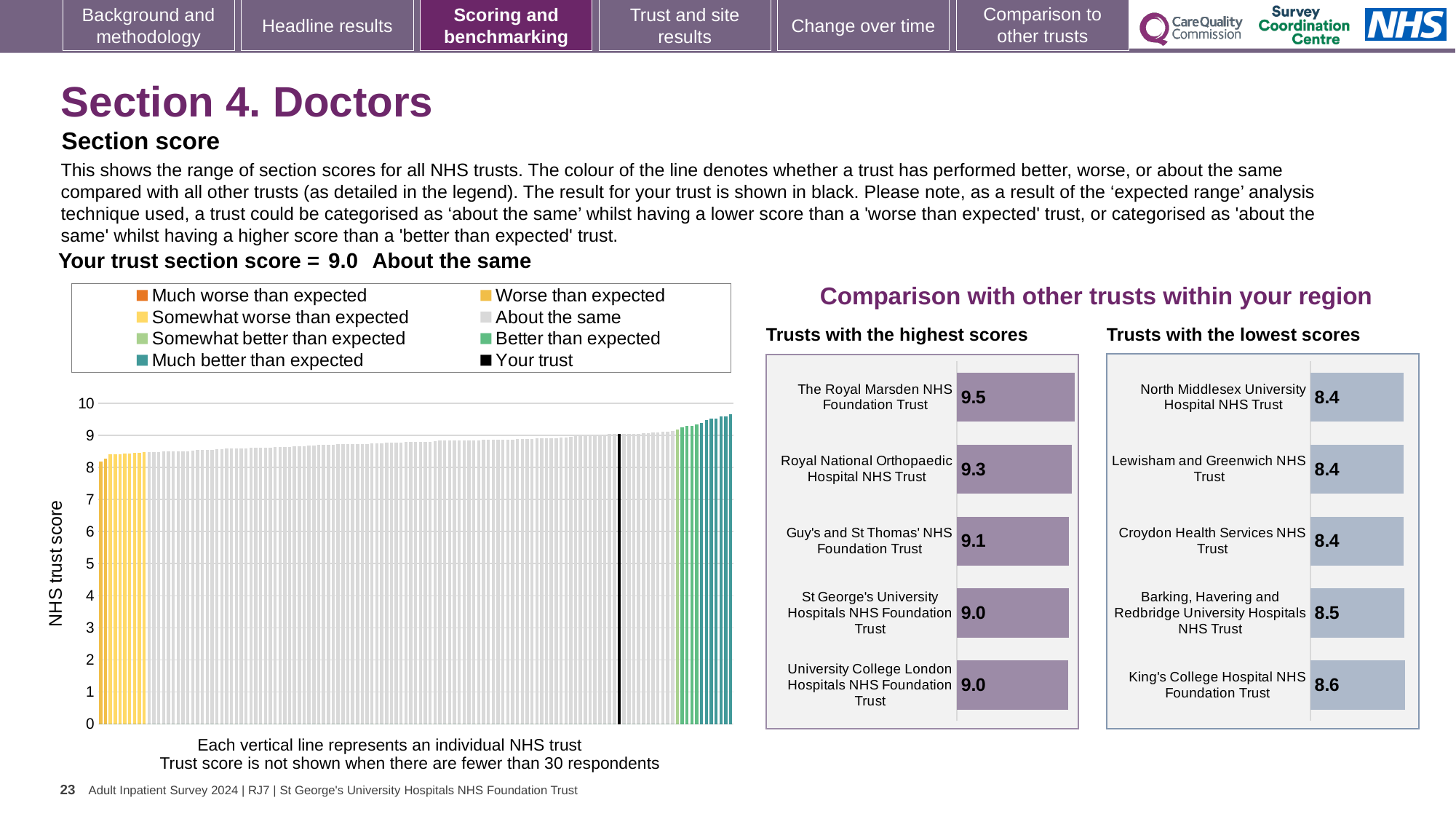
In the 'Trusts with the highest scores' chart, how many trusts are shown? 5 In the 'Trusts with the highest scores' chart, which has the larger score: Royal National Orthopaedic Hospital NHS Trust or Guy's and St Thomas' NHS Foundation Trust? Royal National Orthopaedic Hospital NHS Trust In the large chart on the left, how many entries does the legend list? 8 In the 'Trusts with the lowest scores' chart, what is the score for King's College Hospital NHS Foundation Trust? 8.6 In the large chart on the left, what colour does the legend use for 'Your trust'? black What kind of chart is the large chart on the left with the y-axis labelled 'NHS trust score'? bar chart In the large chart on the left, is the value of the black bar (your trust) greater or less than 8? greater In the 'Trusts with the highest scores' chart, what is the difference between the scores of The Royal Marsden NHS Foundation Trust and Guy's and St Thomas' NHS Foundation Trust? 0.4 In the 'Trusts with the highest scores' chart, which trust has the highest score? The Royal Marsden NHS Foundation Trust In the 'Trusts with the lowest scores' chart, what is the difference between the scores of King's College Hospital NHS Foundation Trust and Barking, Havering and Redbridge University Hospitals NHS Trust? 0.1 In the large chart on the left, do the trust scores rise or fall from left to right along the x axis? rise In the 'Trusts with the highest scores' chart, what is the score for The Royal Marsden NHS Foundation Trust? 9.5